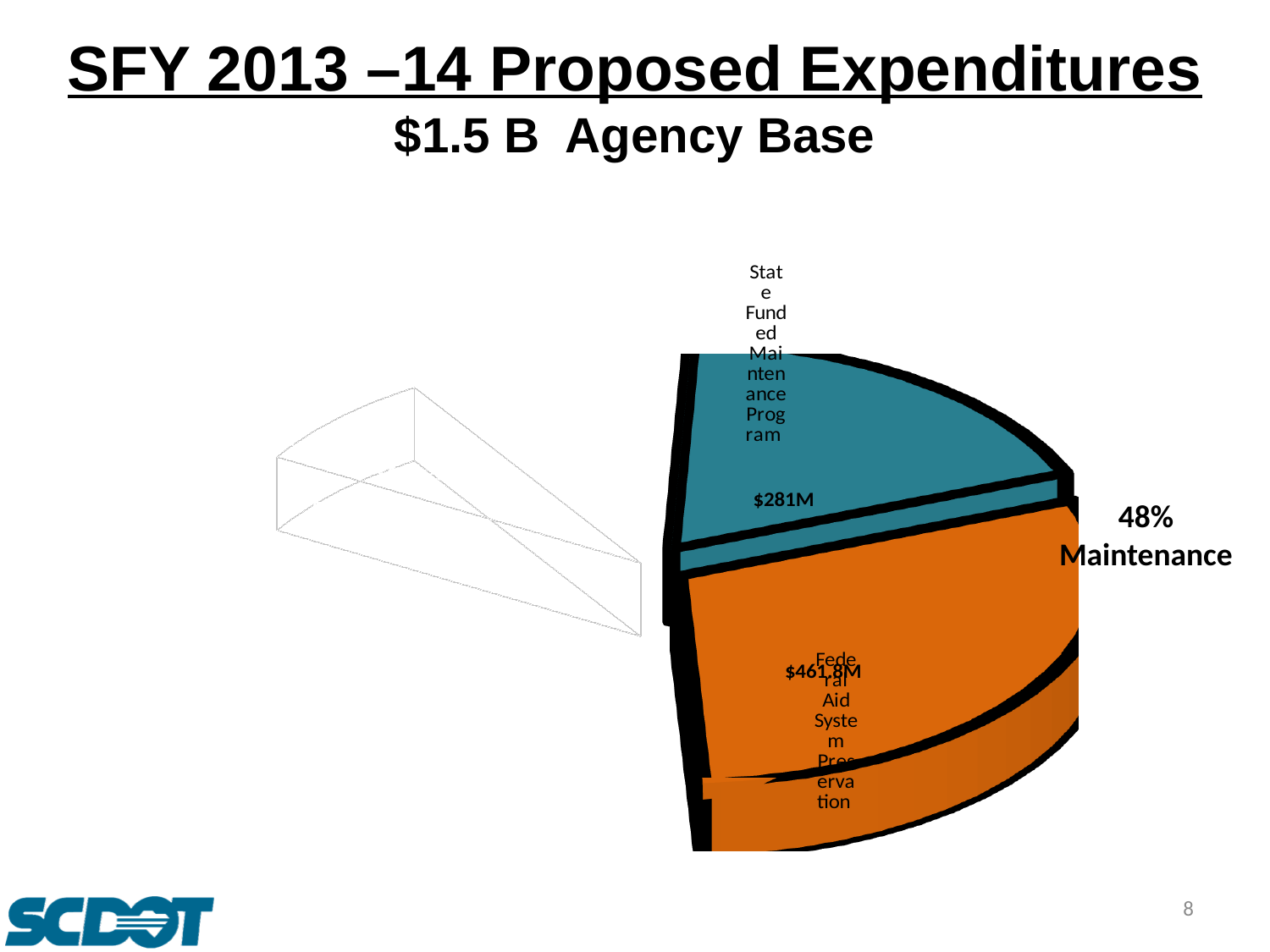
What is the value shown for the State Funded Maintenance Program slice? $281M Which labelled slice has the largest value? Federal Aid System Preservation Which labelled slice has the larger value, State Funded Maintenance Program or Federal Aid System Preservation? Federal Aid System Preservation Which labelled slice has the smaller value? State Funded Maintenance Program What is the difference between the Federal Aid System Preservation value and the State Funded Maintenance Program value? $180.8M What kind of chart is shown on the slide? Pie chart What is the value shown for the Federal Aid System Preservation slice? $461.8M What is the title of the slide? SFY 2013 –14 Proposed Expenditures What percentage is labelled next to the word Maintenance on the chart? 48% What colour is the State Funded Maintenance Program slice? Teal